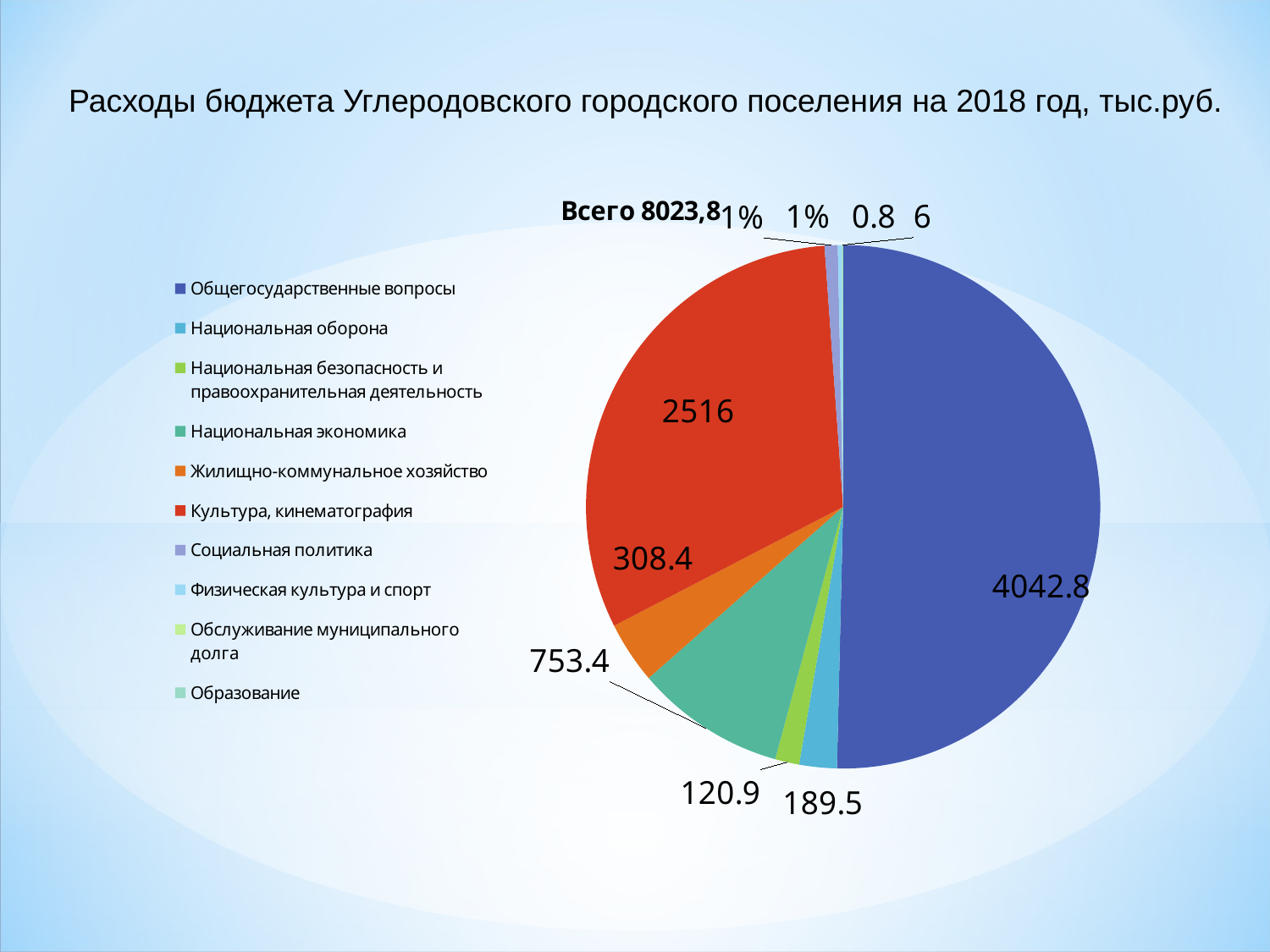
How many categories does the legend list? 10 What is the difference between the values for Общегосударственные вопросы and Культура, кинематография? 1526.8 What is the value for Жилищно-коммунальное хозяйство? 308.4 Which is larger: Культура, кинематография or Национальная экономика? Культура, кинематография What is the value for Национальная экономика? 753.4 What is the title of the slide? Расходы бюджета Углеродовского городского поселения на 2018 год, тыс.руб. What is the value for Национальная оборона? 189.5 What is the total of all expenditures shown on the chart? 8023,8 What is the value for Культура, кинематография? 2516 What is the value for Общегосударственные вопросы? 4042.8 What kind of chart is shown on the slide? pie chart Which category has the largest slice of the pie? Общегосударственные вопросы